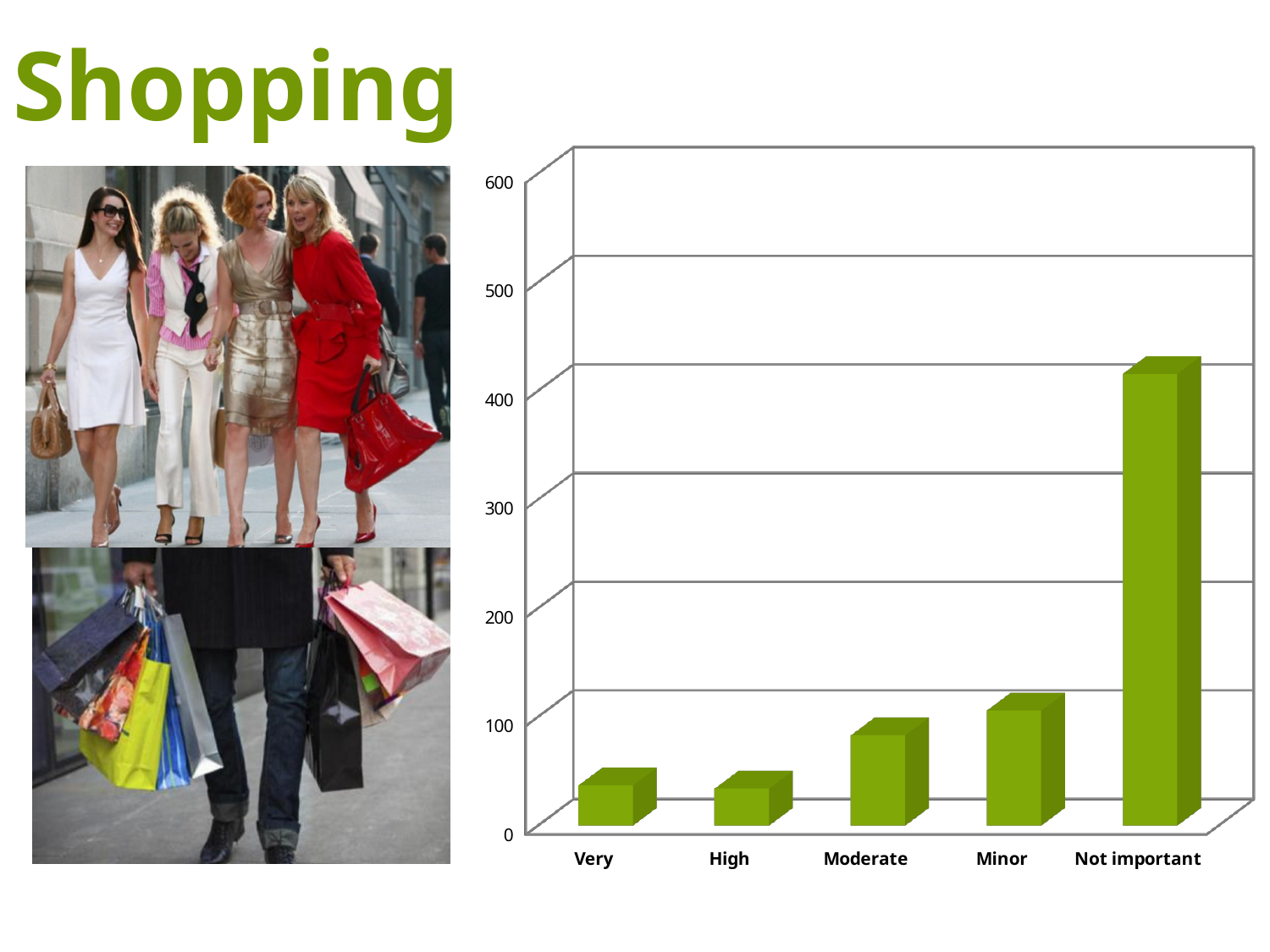
Which category has the highest value in the chart? Not important Which is larger, the value for Moderate or the value for Very? Moderate How many categories are shown on the x axis of the chart? 5 What colour are the bars in the chart? green Is the value for Minor greater or less than 200? less Is the value for Moderate greater or less than 200? less What kind of chart is shown on the slide? bar chart Which is larger, the value for Minor or the value for High? Minor Is the value for High greater or less than 100? less Which is larger, the value for Not important or the value for Minor? Not important